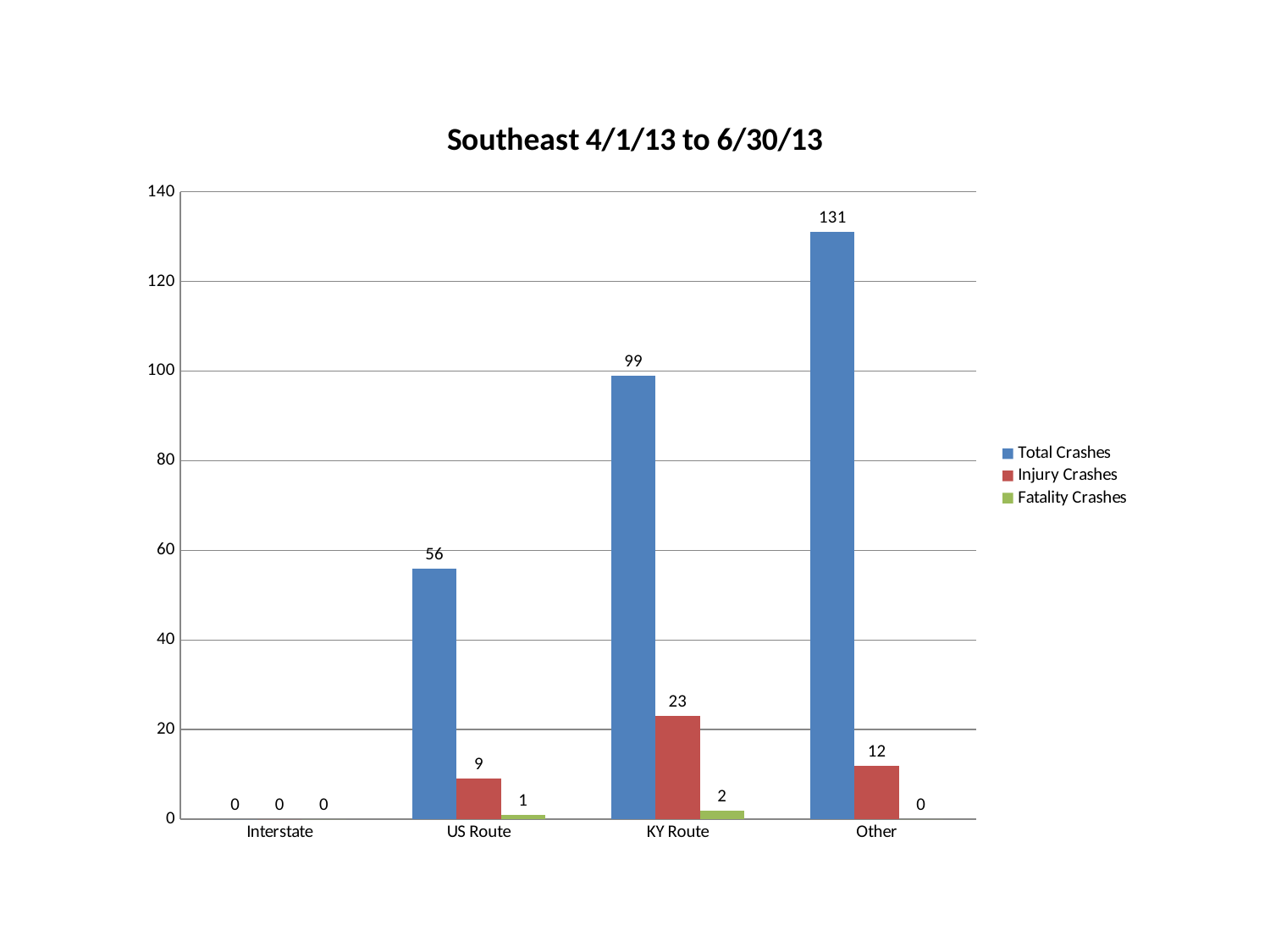
What is the title of the chart? Southeast 4/1/13 to 6/30/13 What is the value of Fatality Crashes for KY Route? 2 How many categories are shown on the x axis? 4 How many series does the legend list? 3 Which category has the lowest Total Crashes? Interstate What is the value of Injury Crashes for Other? 12 What is the difference between Total Crashes for Other and Total Crashes for KY Route? 32 Which is larger: Injury Crashes for KY Route or Injury Crashes for Other? KY Route What is the value of Total Crashes for KY Route? 99 Which category has the highest Total Crashes? Other What is the value of Injury Crashes for US Route? 9 What kind of chart is shown on the slide? Bar chart